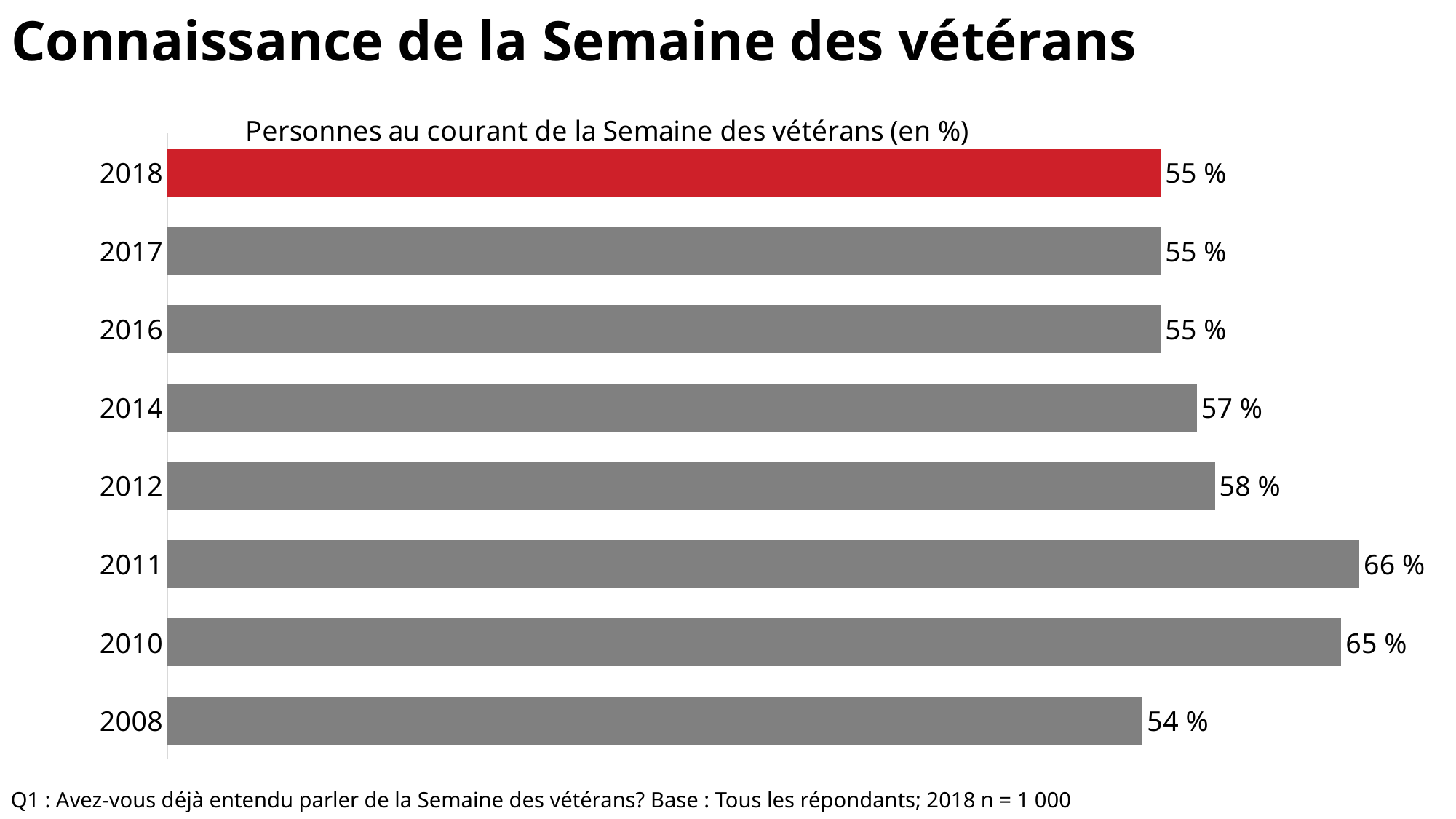
Which year has the lowest value? 2008 Which is larger, the value for 2014 or the value for 2010? 2010 What kind of chart is shown on the slide? Bar chart What is the title of the chart? Personnes au courant de la Semaine des vétérans (en %) Which year has the highest value? 2011 How many years are shown in the chart? 8 What is the value for 2012? 58 % What is the difference between the values for 2011 and 2018? 11 % What is the value for 2011? 66 % What is the value for 2008? 54 % What is the difference between the values for 2010 and 2008? 11 % What is the value for 2018? 55 %